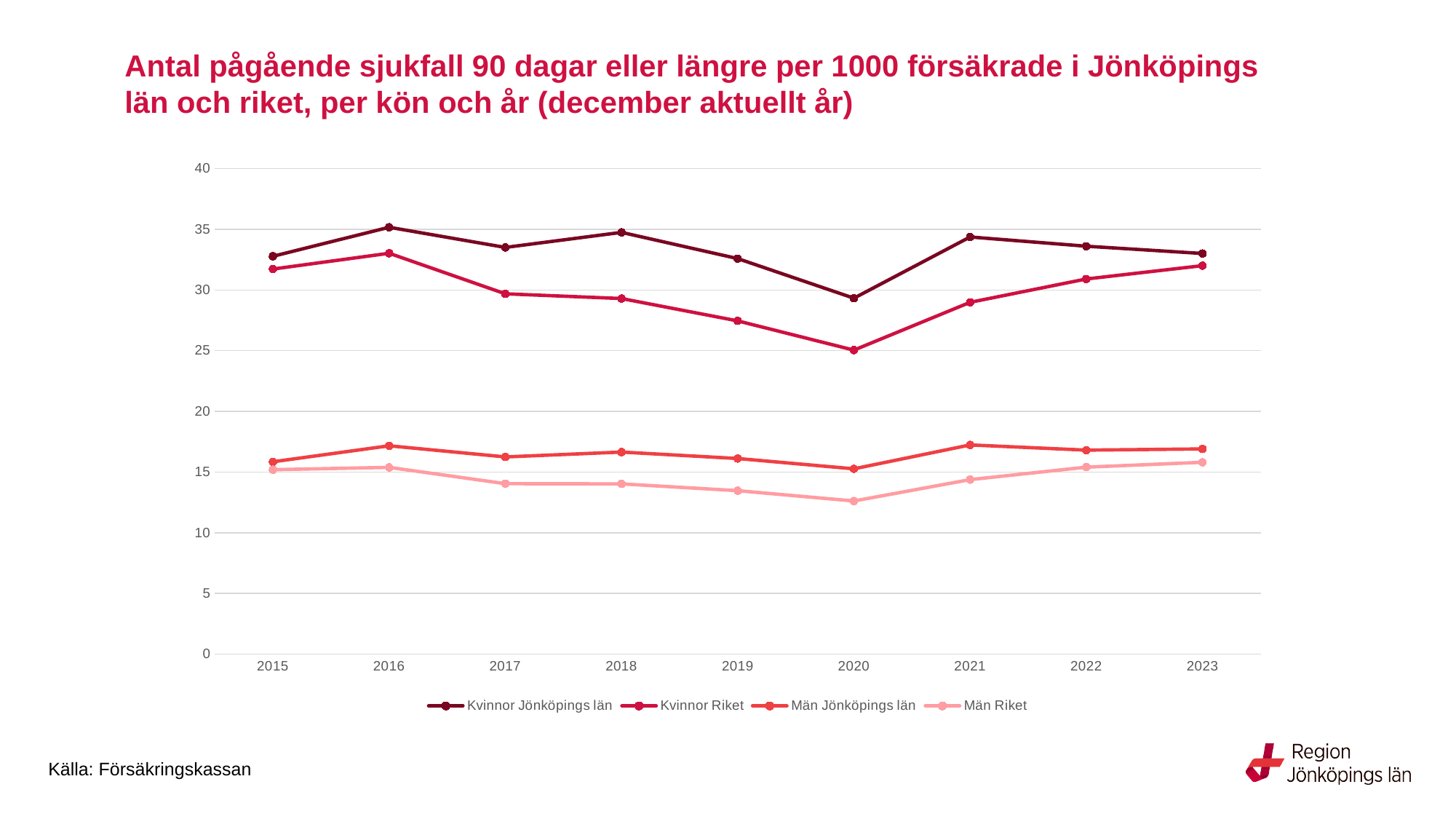
How many years are plotted along the x axis? 9 How many series does the legend list? 4 Does the value for Kvinnor Riket rise or fall from 2016 to 2020? Fall What source is cited at the bottom of the slide? Försäkringskassan In which year is the value for Män Riket lowest? 2020 In which year is the value for Kvinnor Jönköpings län lowest? 2020 Is the value for Kvinnor Riket in 2020 greater or less than 30? less Is the value for Män Jönköpings län in 2016 greater or less than 15? greater In which year is the value for Kvinnor Riket lowest? 2020 In 2020, which is larger: Kvinnor Jönköpings län or Kvinnor Riket? Kvinnor Jönköpings län What kind of chart is shown on the slide? Line chart Is the value for Män Riket in 2020 greater or less than 15? less